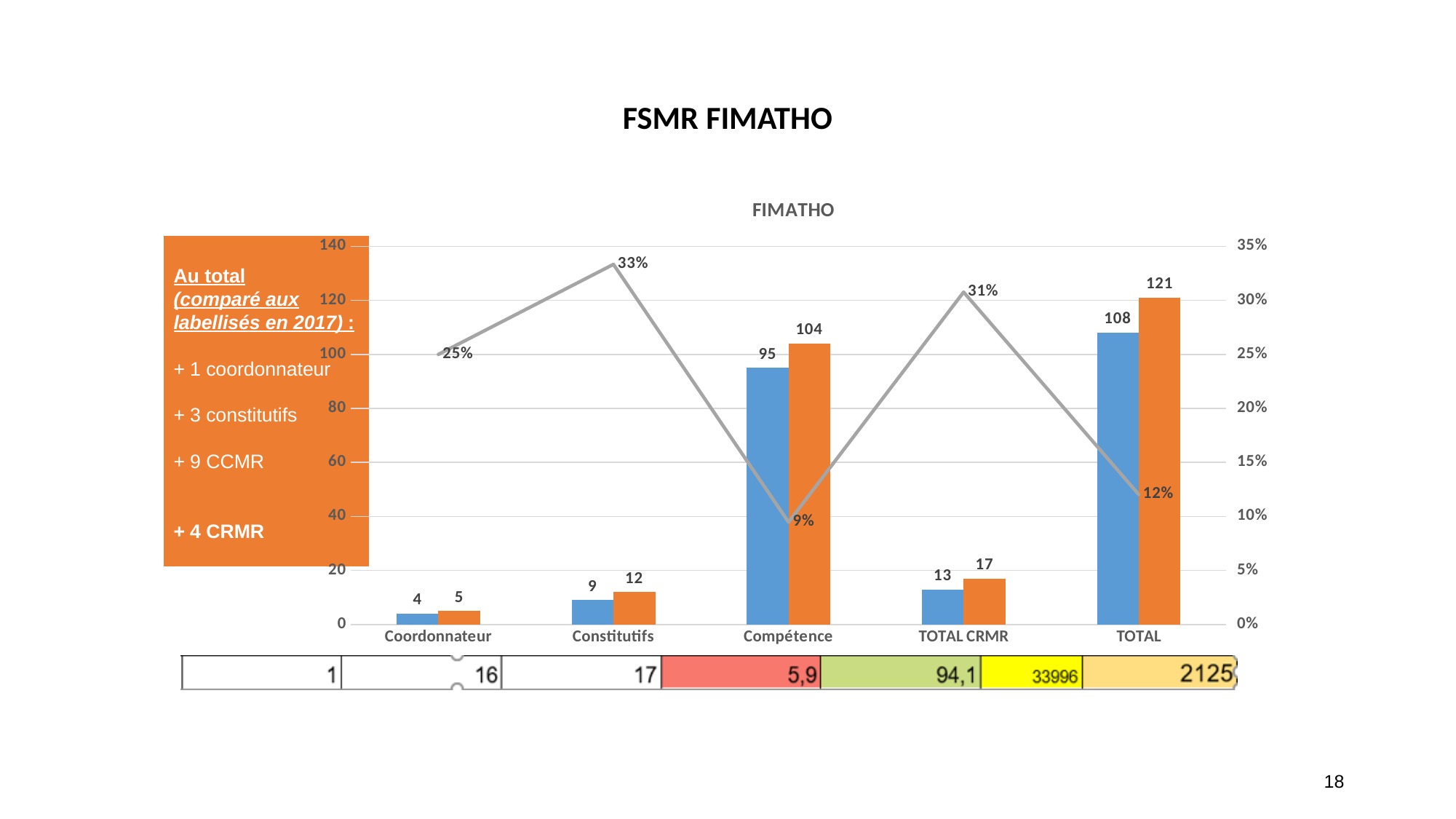
What kind of chart is shown? combined bar and line chart Which category has the highest percentage on the grey line? Constitutifs What is the difference between the orange bar and the blue bar for Constitutifs? 3 What is the value of the blue bar for TOTAL? 108 Which category has the lowest value for the blue bars? Coordonnateur Which is larger for Compétence, the blue bar or the orange bar? the orange bar What is the difference between the orange bar and the blue bar for TOTAL? 13 What is the value of the orange bar for Compétence? 104 How many categories are shown on the x axis? 5 What is the title of the chart? FIMATHO What is the value of the blue bar for TOTAL CRMR? 13 What percentage does the grey line show for Constitutifs? 33%